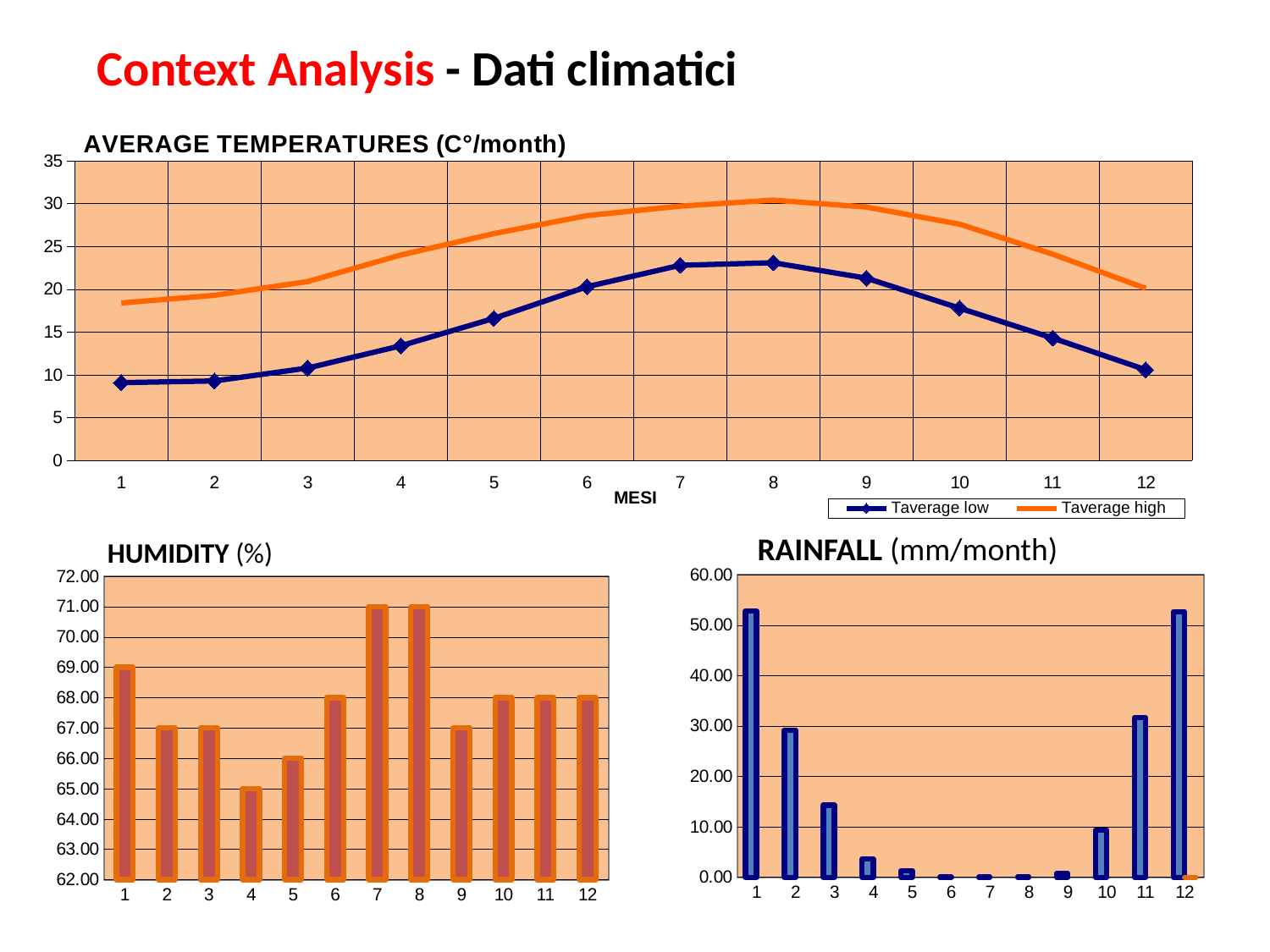
What kind of chart is the AVERAGE TEMPERATURES chart? line chart What kind of chart is the HUMIDITY chart? bar chart In the AVERAGE TEMPERATURES chart, is the Taverage low value for month 1 greater or less than 10? less How many months are shown on the x axis of the RAINFALL chart? 12 How many series does the legend of the AVERAGE TEMPERATURES chart list? 2 In the HUMIDITY chart, which month has the lowest value? 4 In the AVERAGE TEMPERATURES chart, is the Taverage high value for month 1 greater or less than 20? less In the AVERAGE TEMPERATURES chart, which month has the highest Taverage low value? 8 In the AVERAGE TEMPERATURES chart, do the Taverage high values rise or fall from month 8 to month 12? fall In the HUMIDITY chart, what is the value for month 1? 69.00 In the HUMIDITY chart, what is the difference between the values for month 7 and month 4? 6.00 In the RAINFALL chart, is the value for month 2 greater or less than 20.00? greater